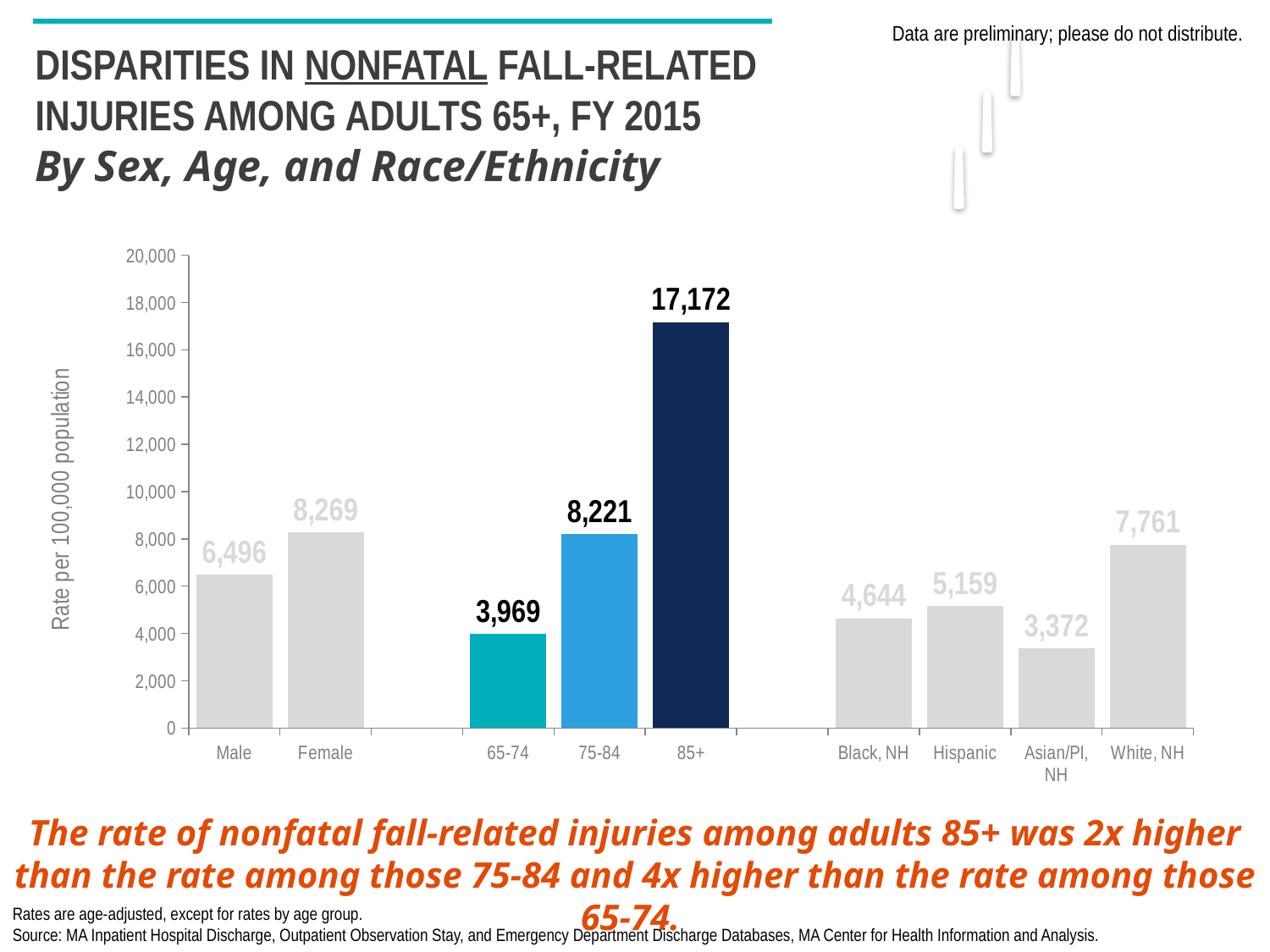
What is the rate for Female? 8,269 What kind of chart is shown on the slide? bar chart What is the difference between the rates for 85+ and 75-84? 8,951 Is the value for White, NH greater or less than 8,000? less What is the label of the y axis? Rate per 100,000 population Which category has the highest rate on the chart? 85+ Which has a higher rate, Hispanic or Black, NH? Hispanic What is the difference between the rates for Female and Male? 1,773 What is the rate of nonfatal fall-related injuries for adults 85+? 17,172 How many categories are shown on the x axis? 9 Which category has the lowest rate on the chart? Asian/PI, NH What is the rate for Asian/PI, NH? 3,372